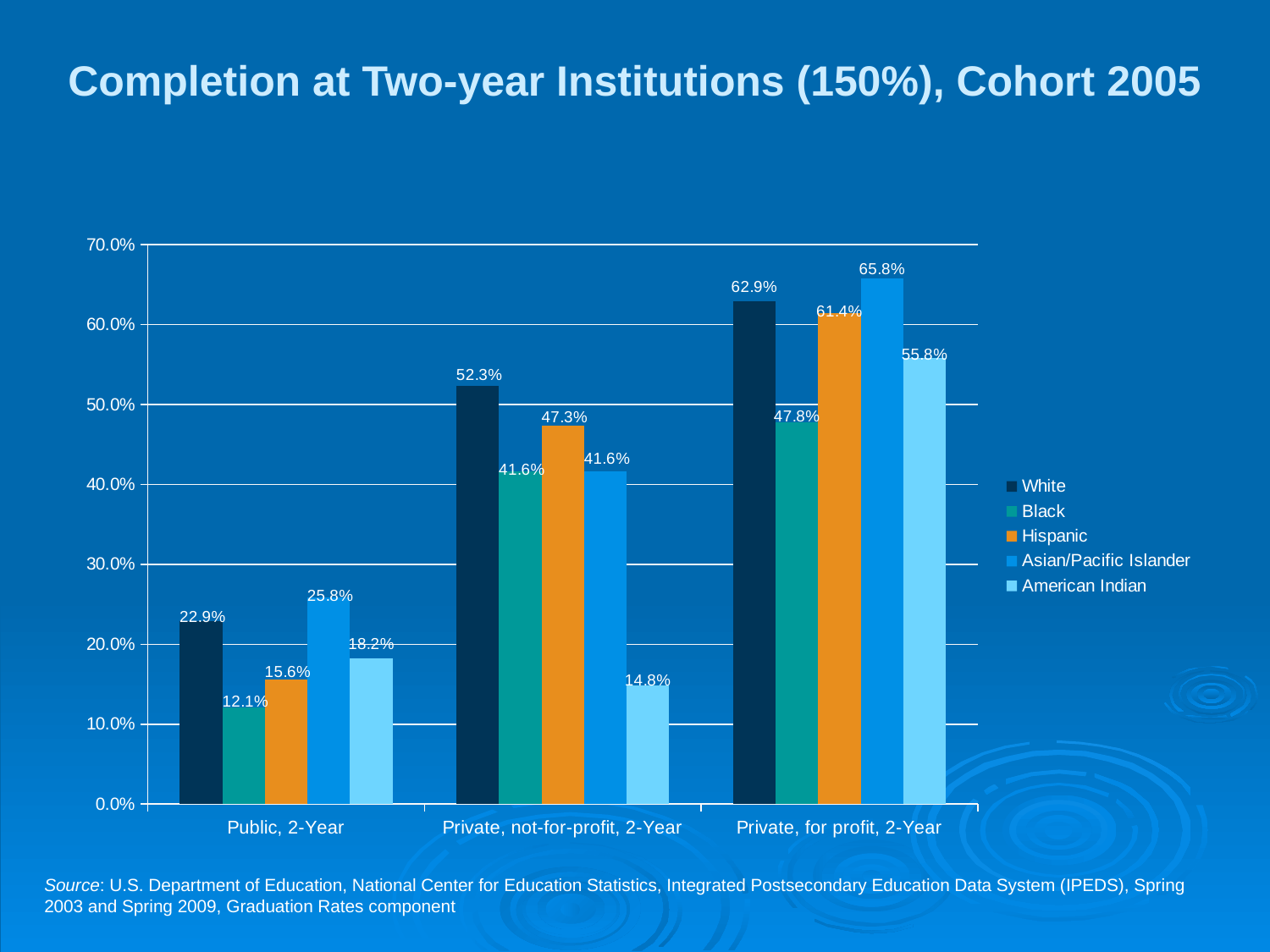
Which group has the highest completion rate at Private, for profit, 2-Year institutions? Asian/Pacific Islander What is the completion rate for American Indian students at Private, not-for-profit, 2-Year institutions? 14.8% How many institution categories are shown on the x axis? 3 Does the completion rate for White students rise or fall across the categories from Public, 2-Year to Private, for profit, 2-Year? Rise How many series does the legend list? 5 What is the completion rate for White students at Public, 2-Year institutions? 22.9% What is the completion rate for Hispanic students at Private, for profit, 2-Year institutions? 61.4% Is the completion rate for Black students at Private, for profit, 2-Year institutions greater or less than 50.0%? less What is the difference between the White and Black completion rates at Private, not-for-profit, 2-Year institutions? 10.7% What kind of chart is shown on the slide? Bar chart Which is larger: the Hispanic completion rate at Public, 2-Year institutions or the American Indian completion rate at Public, 2-Year institutions? American Indian Which group has the lowest completion rate at Public, 2-Year institutions? Black